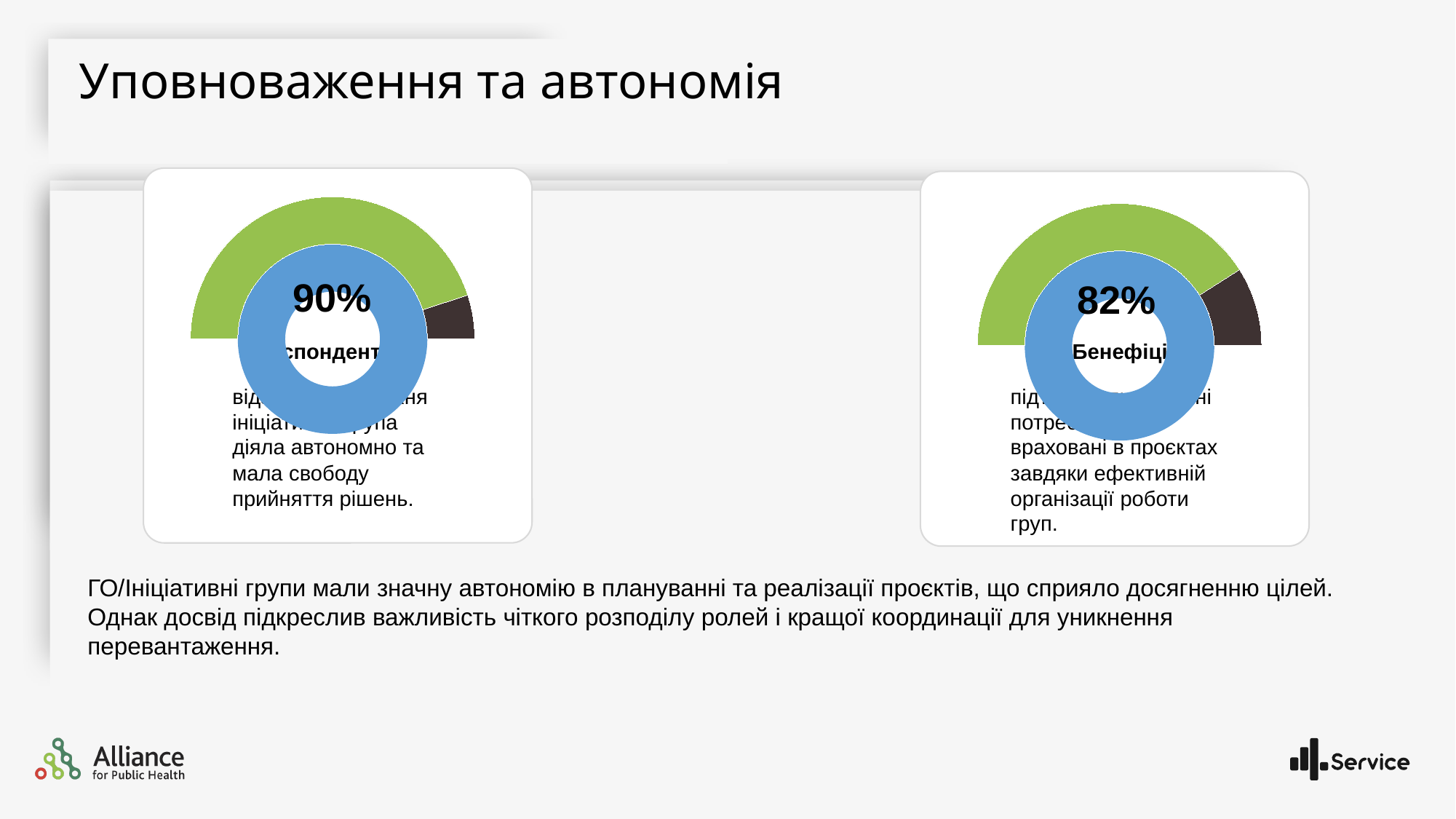
In the right chart, what share of the gauge is not filled green? 18% What kind of chart is used on this slide? semicircular gauge (doughnut) chart What percentage is shown in the left gauge chart? 90% What colour is the filled portion of the gauges? green Is the value in the right chart greater or less than 90%? less What is the title of the slide? Уповноваження та автономія What is the difference between the percentage in the left chart and the percentage in the right chart? 8% How many gauge charts are on the slide? 2 Which chart shows the larger percentage, the left one or the right one? the left one (90%) What percentage is shown in the right gauge chart? 82% In the left chart, what share of the gauge is not filled green? 10% Is the value in the left chart greater or less than 80%? greater